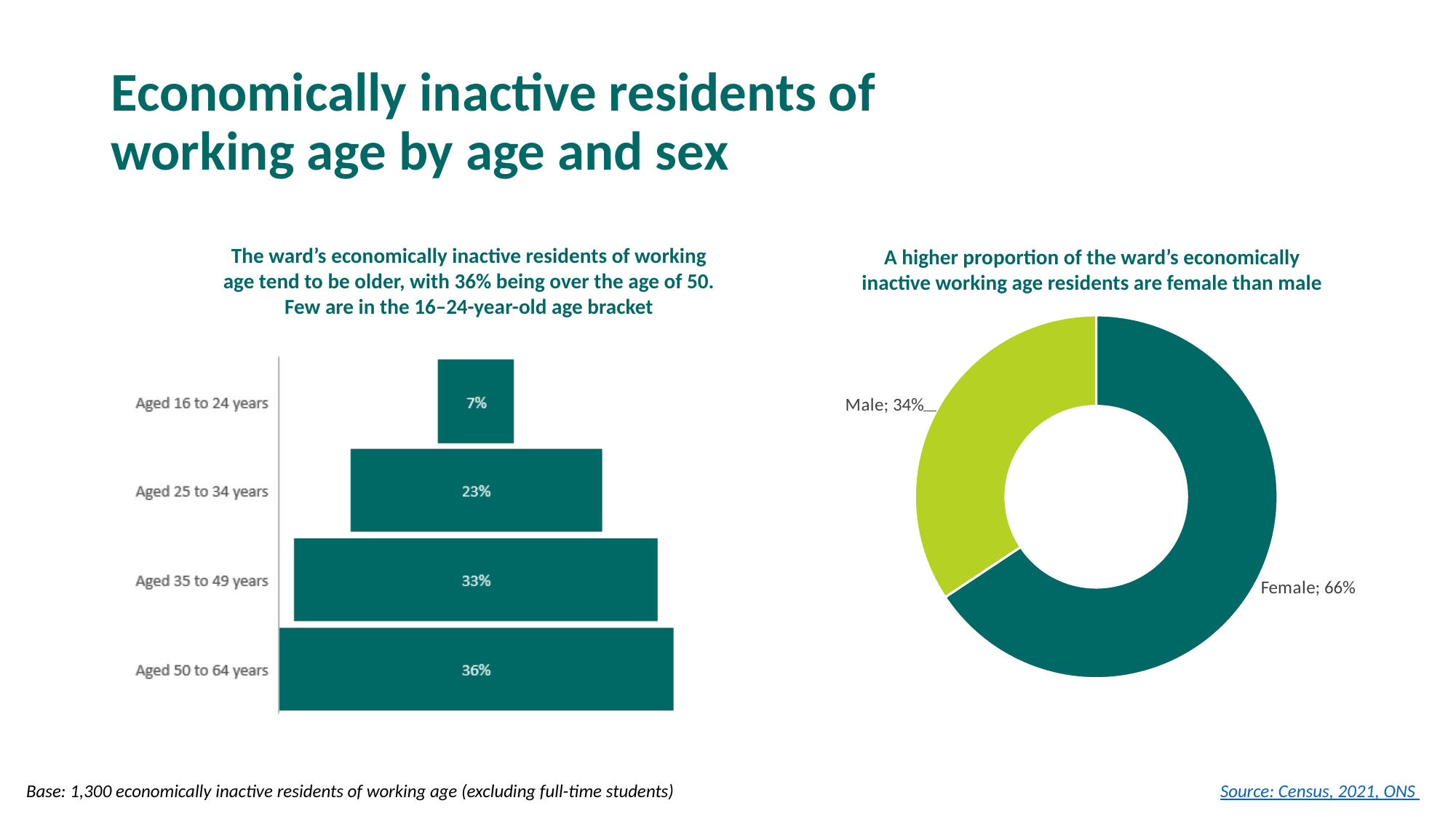
In the doughnut chart on the right, what is the difference between the Female and Male shares? 32% In the age bar chart on the left, which age group has the highest value? Aged 50 to 64 years In the doughnut chart on the right, what share is Female? 66% How many age categories are shown in the bar chart on the left? 4 In the age bar chart on the left, what is the difference between the values for Aged 35 to 49 years and Aged 16 to 24 years? 26% In the age bar chart on the left, what is the value for Aged 25 to 34 years? 23% In the age bar chart on the left, what is the value for Aged 50 to 64 years? 36% What kind of chart is the chart on the right of the slide? Doughnut chart In the age bar chart on the left, which is larger: the value for Aged 25 to 34 years or Aged 35 to 49 years? Aged 35 to 49 years What kind of chart is the chart on the left of the slide? Bar chart In the age bar chart on the left, which age group has the lowest value? Aged 16 to 24 years In the doughnut chart on the right, what is the value for Male? 34%